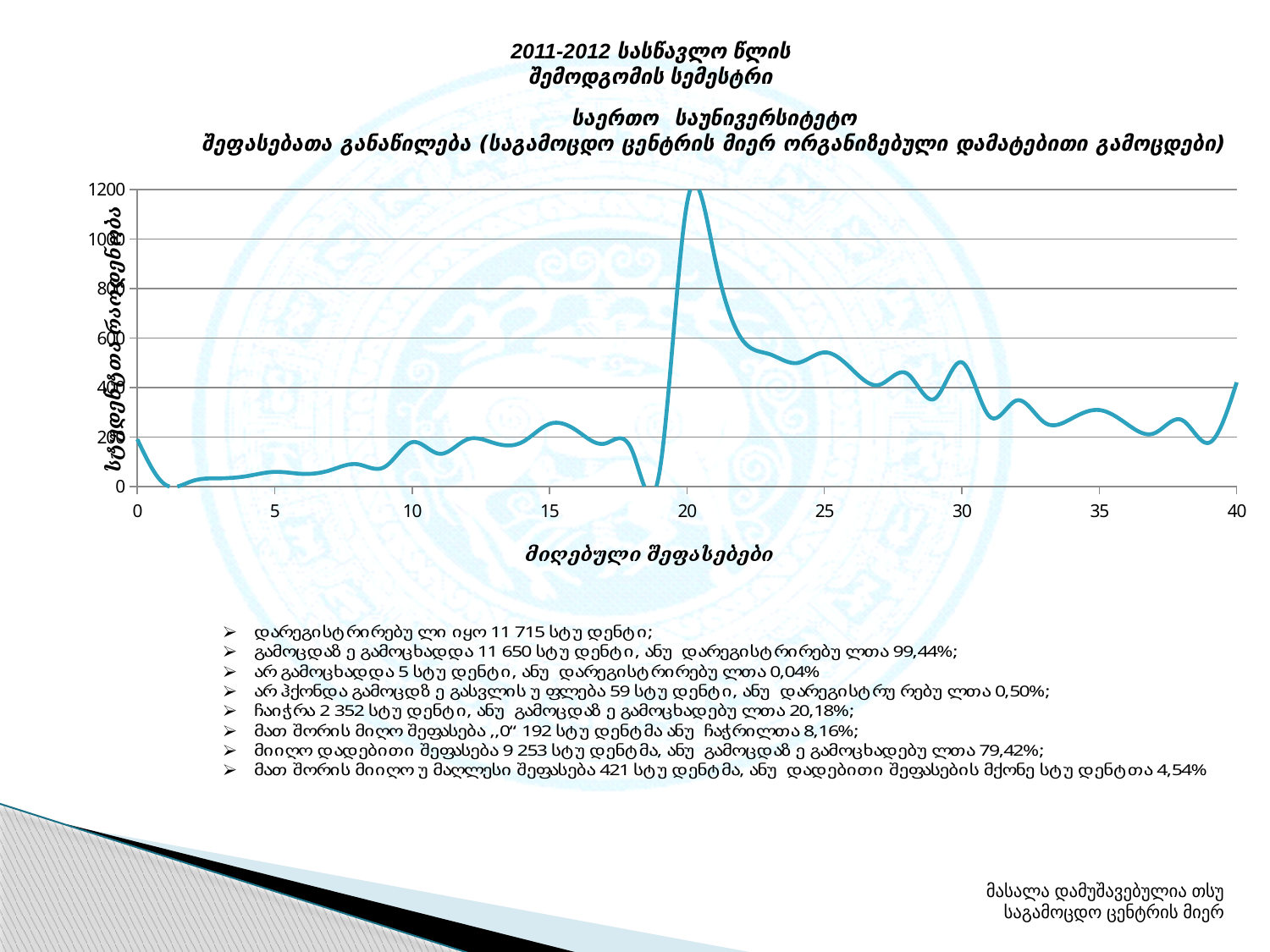
What is the label of the x axis? მიღებული შეფასებები What is the highest tick value shown on the y axis? 1200 How many lines (data series) are plotted on the chart? 1 Is the value of the line at x = 35 greater or less than 400? less What kind of chart is shown on the slide? line chart Is the value of the line at x = 25 greater or less than 400? greater Is the value of the line at x = 25 greater or less than 600? less Which is larger, the value of the line at x = 20 or at x = 30? x = 20 At approximately which score on the x axis does the line reach its highest point? 20